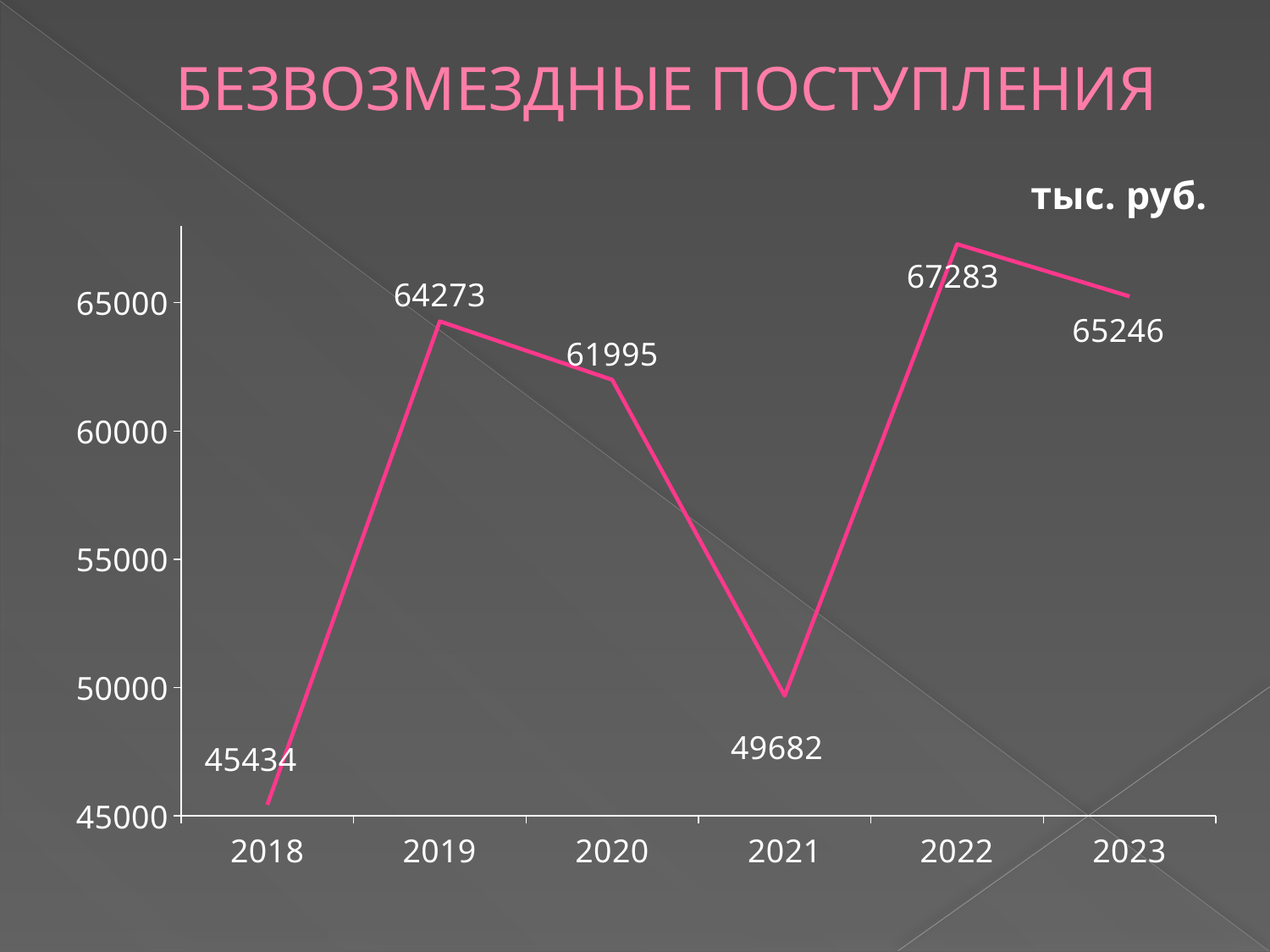
What is the difference between the values for 2022 and 2023? 2037 What kind of chart is shown on the slide? line chart Which is larger, the value for 2019 or the value for 2020? 2019 Which year has the lowest value? 2018 Is the value for 2021 greater or less than 55000? less What is the value for 2021? 49682 What unit is indicated for the values on the chart? тыс. руб. What is the value for 2018? 45434 What is the value for 2023? 65246 How many years are plotted on the chart? 6 What is the difference between the values for 2019 and 2018? 18839 Which year has the highest value? 2022